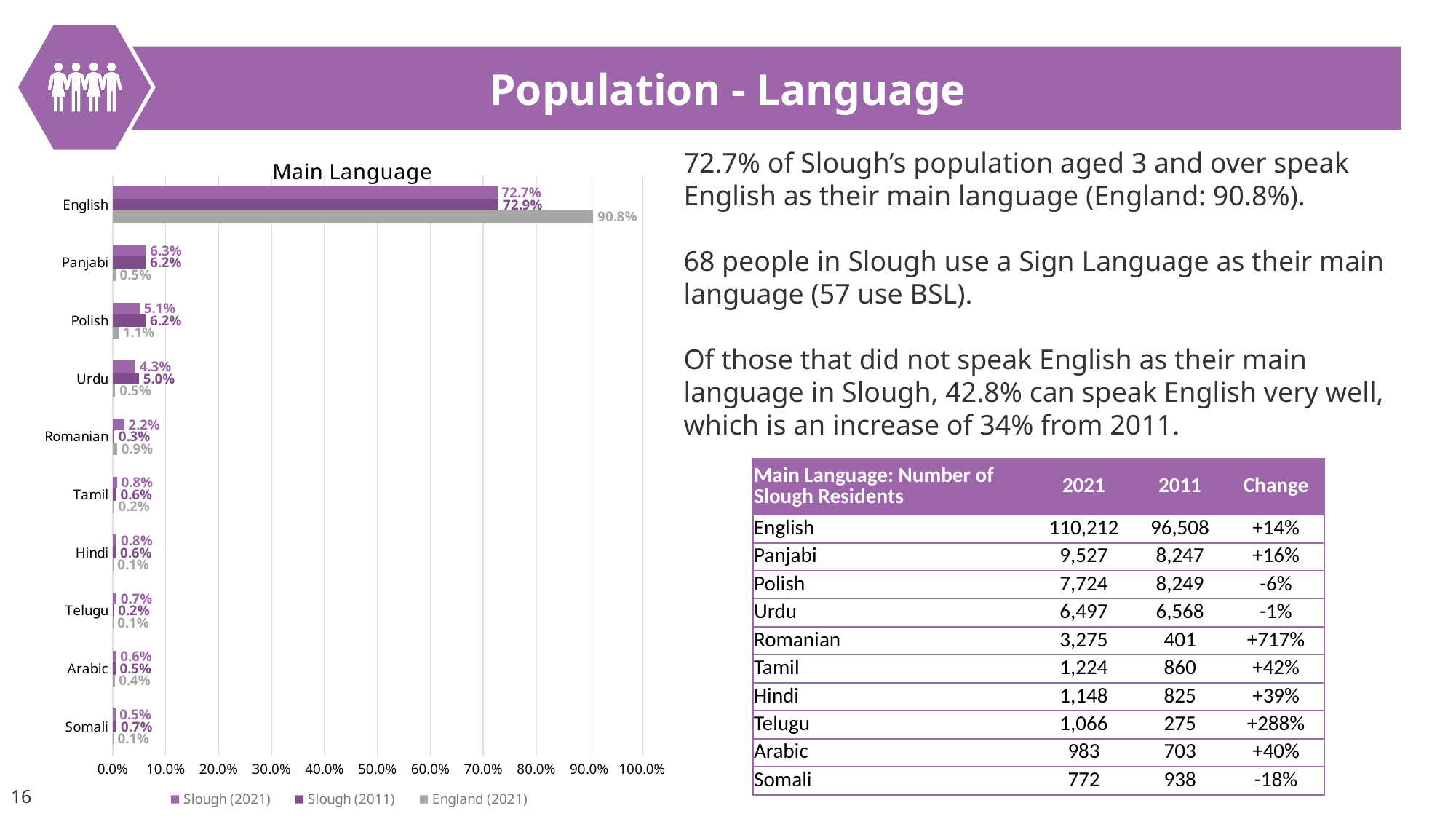
In the Main Language chart, which is larger for Polish: the Slough (2021) value or the Slough (2011) value? Slough (2011) How many languages are shown in the Main Language chart? 10 Which language has the lowest Slough (2011) value in the Main Language chart? Telugu In the Main Language chart, is the England (2021) value for English greater or less than 80.0%? greater What is the Slough (2021) value for English in the Main Language chart? 72.7% How many series does the legend of the Main Language chart list? 3 What is the title of the chart on the slide? Main Language What kind of chart is the Main Language chart? bar chart Which language has the highest Slough (2021) value in the Main Language chart? English What is the Slough (2011) value for Urdu in the Main Language chart? 5.0% What is the England (2021) value for Polish in the Main Language chart? 1.1% In the Main Language chart, what is the difference between the England (2021) and Slough (2021) values for English? 18.1%